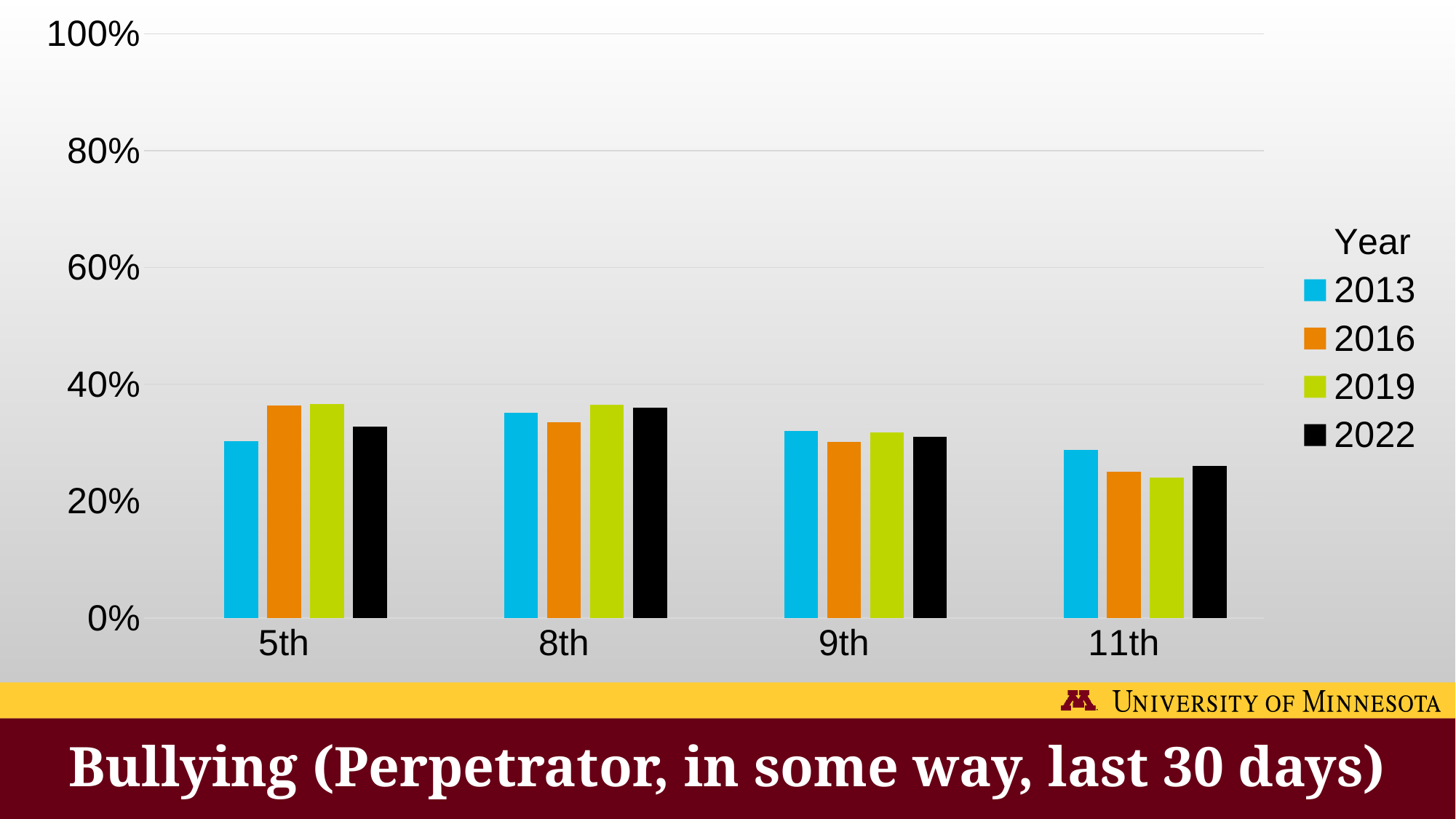
What is the title of the chart? Bullying (Perpetrator, in some way, last 30 days) In 5th grade, which year has the lowest value? 2013 How many series does the legend list? 4 Is the value for 2016 in 5th grade greater or less than 40%? less How many grade categories are shown on the x axis? 4 What is the title of the legend? Year Is the value for 2019 in 11th grade greater or less than 30%? less In 5th grade, which is larger, the value for 2013 or the value for 2016? 2016 In 11th grade, which is larger, the value for 2013 or the value for 2019? 2013 Is the value for 2013 in 5th grade greater or less than 20%? greater In 11th grade, which year has the highest value? 2013 What kind of chart is shown on the slide? bar chart